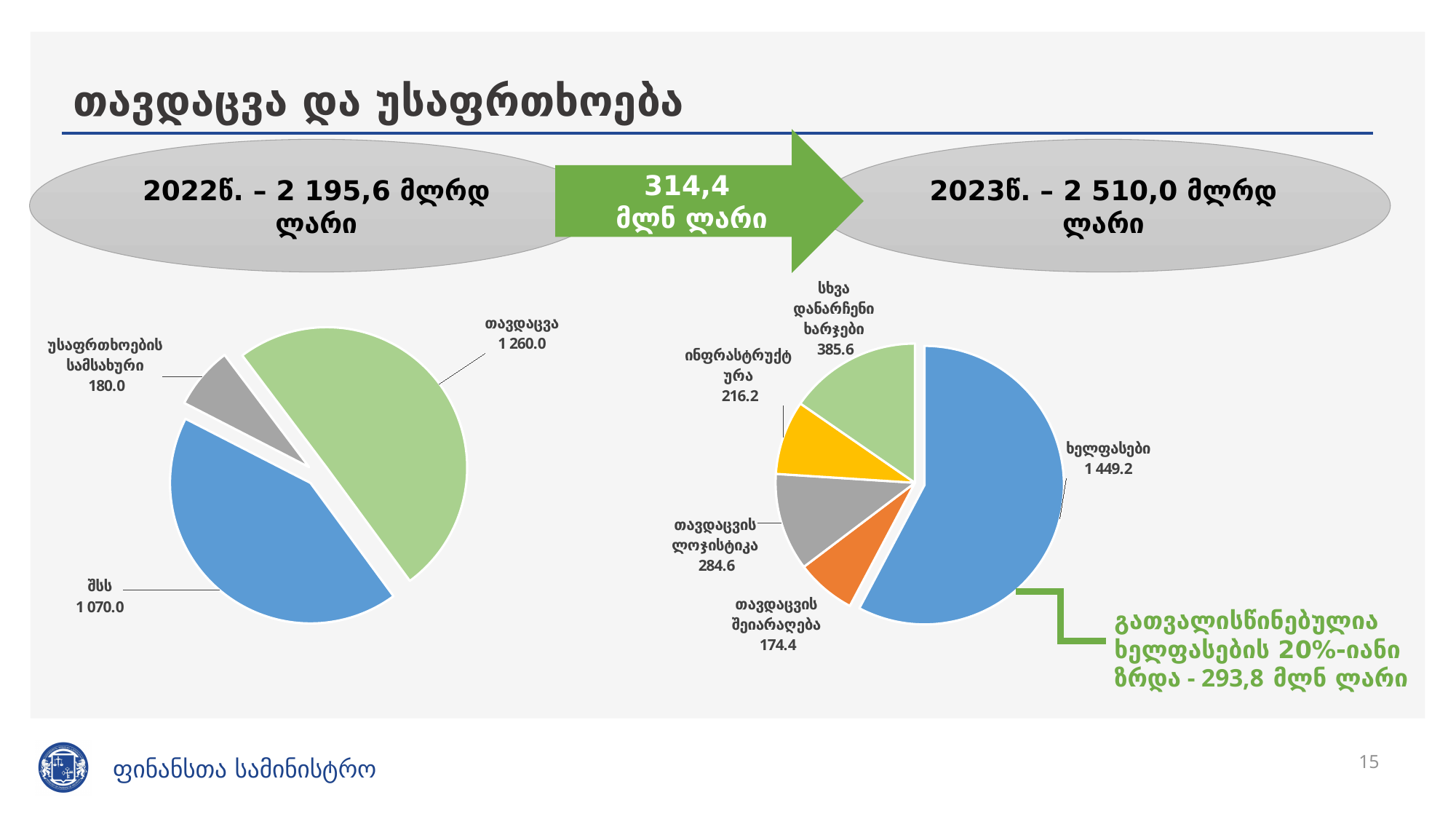
In the right pie chart, which is larger: სხვა დანარჩენი ხარჯები or ინფრასტრუქტურა? სხვა დანარჩენი ხარჯები In the right pie chart, what is the value for თავდაცვის ლოჯისტიკა? 284.6 In the left pie chart, which category has the smallest slice? უსაფრთხოების სამსახური What type of chart is shown on the right side of the slide? Pie chart In the right pie chart, which category has the smallest slice? თავდაცვის შეიარაღება In the left pie chart, what is the difference between თავდაცვა and შსს? 190.0 In the left pie chart, what is the value for უსაფრთხოების სამსახური? 180.0 In the right pie chart, what is the value for ხელფასები? 1 449.2 How many slices does the left pie chart have? 3 In the right pie chart, which category has the largest slice? ხელფასები In the left pie chart, what is the value for თავდაცვა? 1 260.0 In the left pie chart, what is the value for შსს? 1 070.0